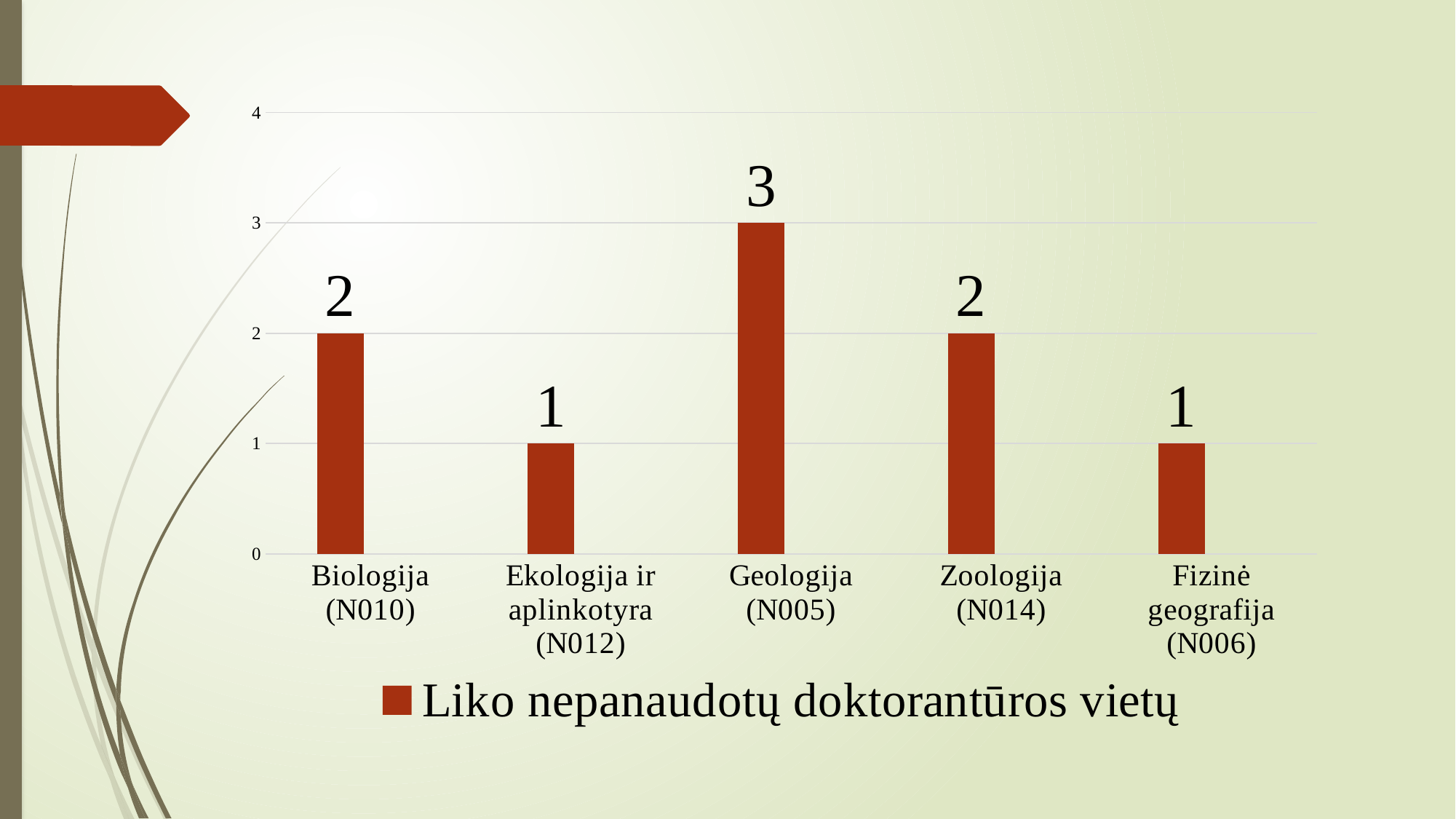
What is the value for Biologija (N010)? 2 What is the series name shown in the legend? Liko nepanaudotų doktorantūros vietų How many categories are shown on the x axis? 5 How many series does the legend list? 1 What is the difference between the values for Geologija (N005) and Zoologija (N014)? 1 What is the value for Geologija (N005)? 3 What is the value for Ekologija ir aplinkotyra (N012)? 1 Which is larger, the value for Biologija (N010) or the value for Fizinė geografija (N006)? Biologija (N010) Which category has the highest value? Geologija (N005) What kind of chart is shown on the slide? bar chart Is the value for Geologija (N005) greater or less than 2? greater What is the highest value shown on the vertical axis? 4